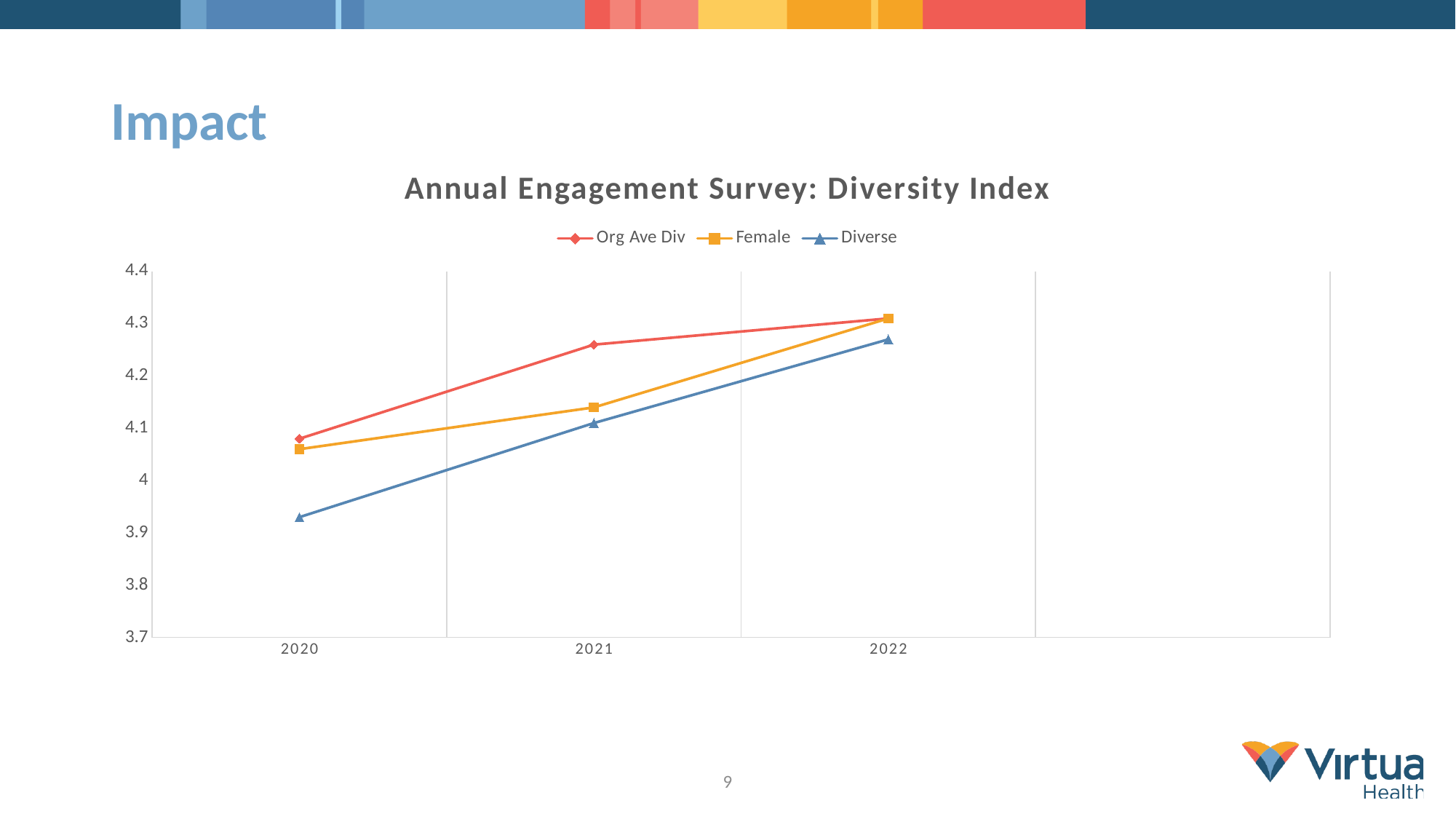
Is the value for Female in 2020 greater or less than 4? greater Is the value for Org Ave Div in 2021 greater or less than 4.2? greater How many years are shown on the x axis? 3 Does the Diverse series rise or fall from 2020 to 2022? rise Is the value for Diverse in 2020 greater or less than 4? less What kind of chart is shown on the slide? line chart How many series does the legend list? 3 Which series has the highest value in 2021? Org Ave Div Which series has the lowest value in 2020? Diverse What is the title of the chart? Annual Engagement Survey: Diversity Index Which series is plotted with triangle markers? Diverse